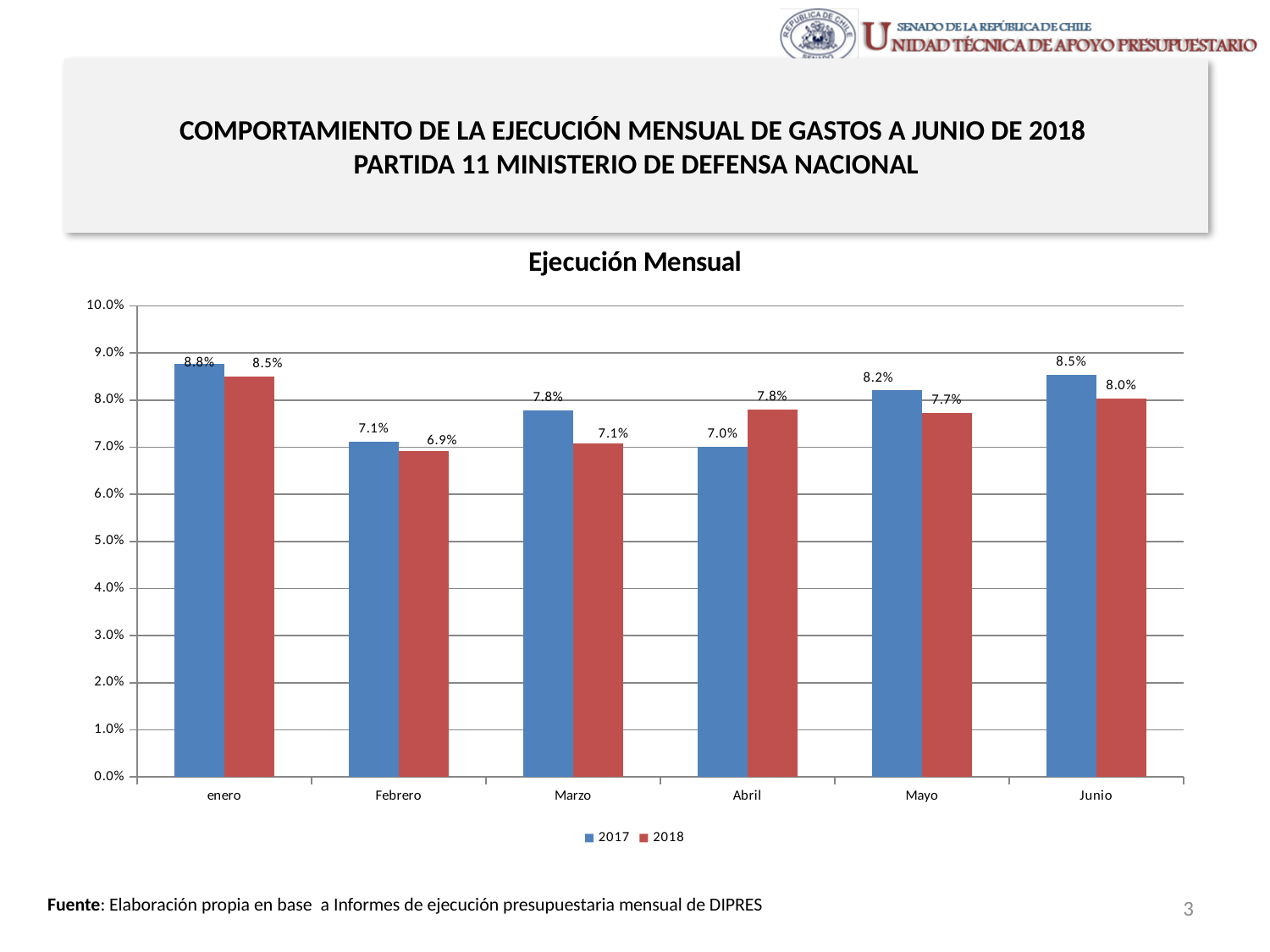
How many series does the legend list? 2 How many months are shown on the x axis? 6 What is the title of the chart? Ejecución Mensual What is the value for 2017 in enero? 8.8% What is the value for 2018 in Abril? 7.8% What is the value for 2018 in Febrero? 6.9% What kind of chart is shown on the slide? bar chart Which month has the highest value for the 2017 series? enero In Abril, which series has the larger value, 2017 or 2018? 2018 What is the difference between the 2017 and 2018 values in Junio? 0.5% What is the value for 2017 in Mayo? 8.2% Which month has the lowest value for the 2018 series? Febrero